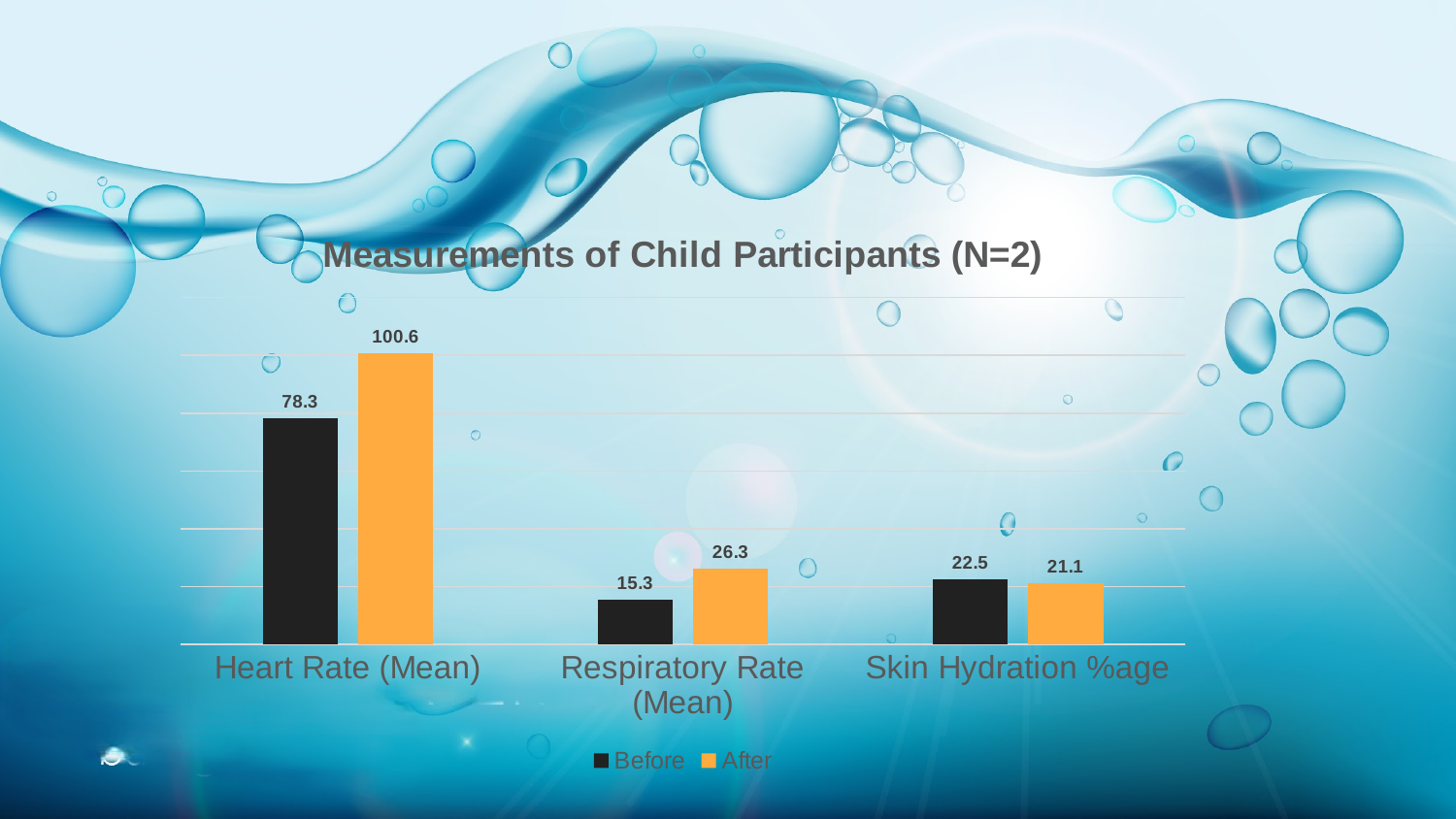
What is the difference between the After and Before values for Heart Rate (Mean)? 22.3 Which category has the lowest Before value? Respiratory Rate (Mean) What is the After value for Heart Rate (Mean)? 100.6 What is the difference between the Before and After values for Skin Hydration %age? 1.4 For Respiratory Rate (Mean), which is larger, the Before or the After value? After What type of chart is shown on the slide? Bar chart What is the Before value for Skin Hydration %age? 22.5 How many categories are shown on the x axis? 3 What is the Before value for Heart Rate (Mean)? 78.3 Which category has the highest After value? Heart Rate (Mean) How many series does the legend list? 2 What is the After value for Respiratory Rate (Mean)? 26.3